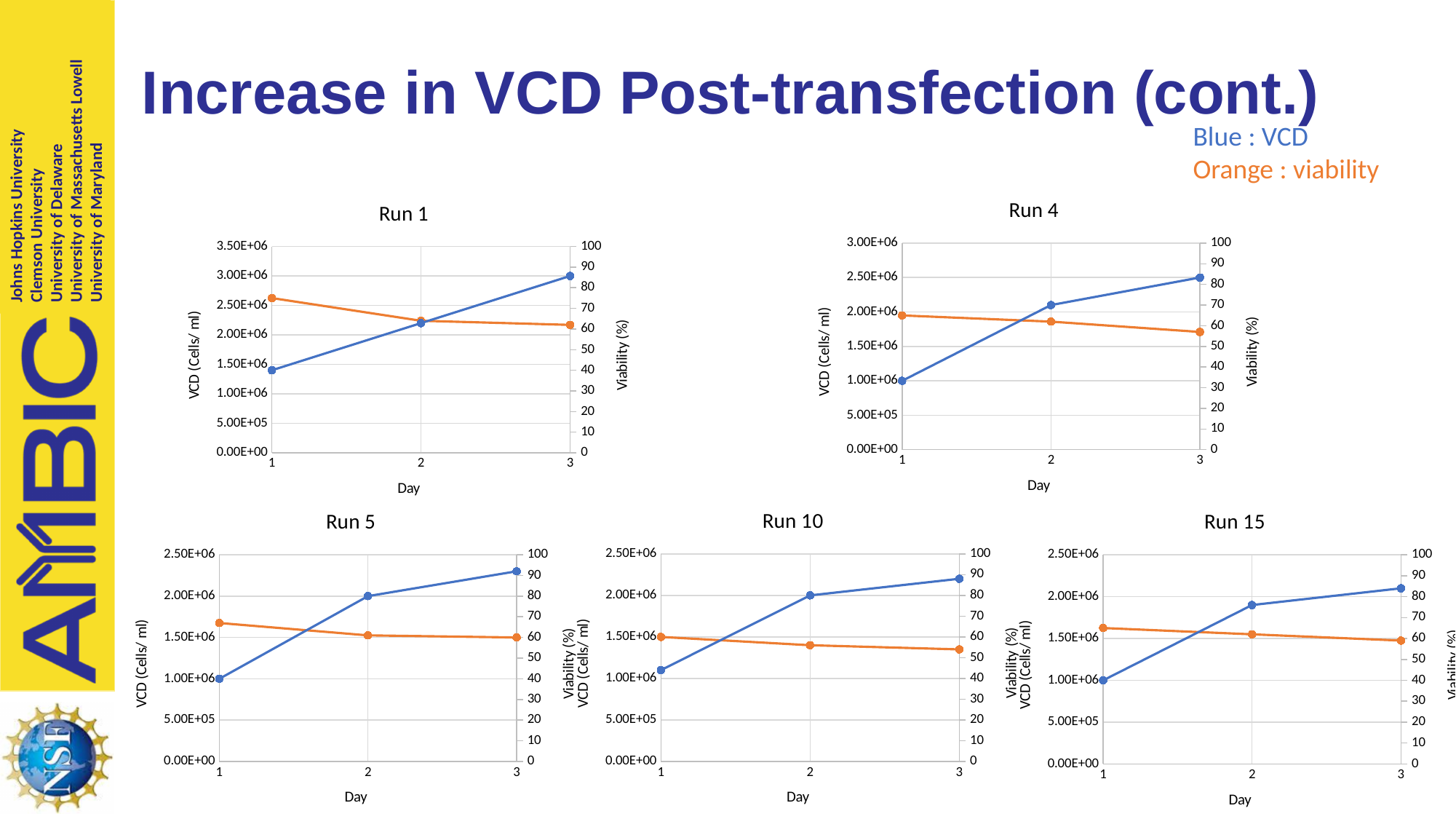
In the Run 10 chart, is the viability value on day 3 greater or less than 60? less What is the label of the right-hand y axis in the Run 4 chart? Viability (%) In the Run 5 chart, how many days are plotted on the x axis? 3 What kind of chart is the Run 1 chart? line chart According to the slide, which quantity does the blue line represent? VCD In the Run 15 chart, what is the VCD value on day 1? 1.00E+06 In the Run 5 chart, what is the VCD value on day 2? 2.00E+06 In the Run 15 chart, does the viability (orange) line rise or fall from day 1 to day 3? fall In the Run 1 chart, is the VCD value on day 3 greater or less than 2.50E+06? greater In the Run 4 chart, does the VCD (blue) line rise or fall from day 1 to day 3? rise In the Run 5 chart, is the VCD value on day 3 greater or less than 2.00E+06? greater How many charts are shown on the slide? 5